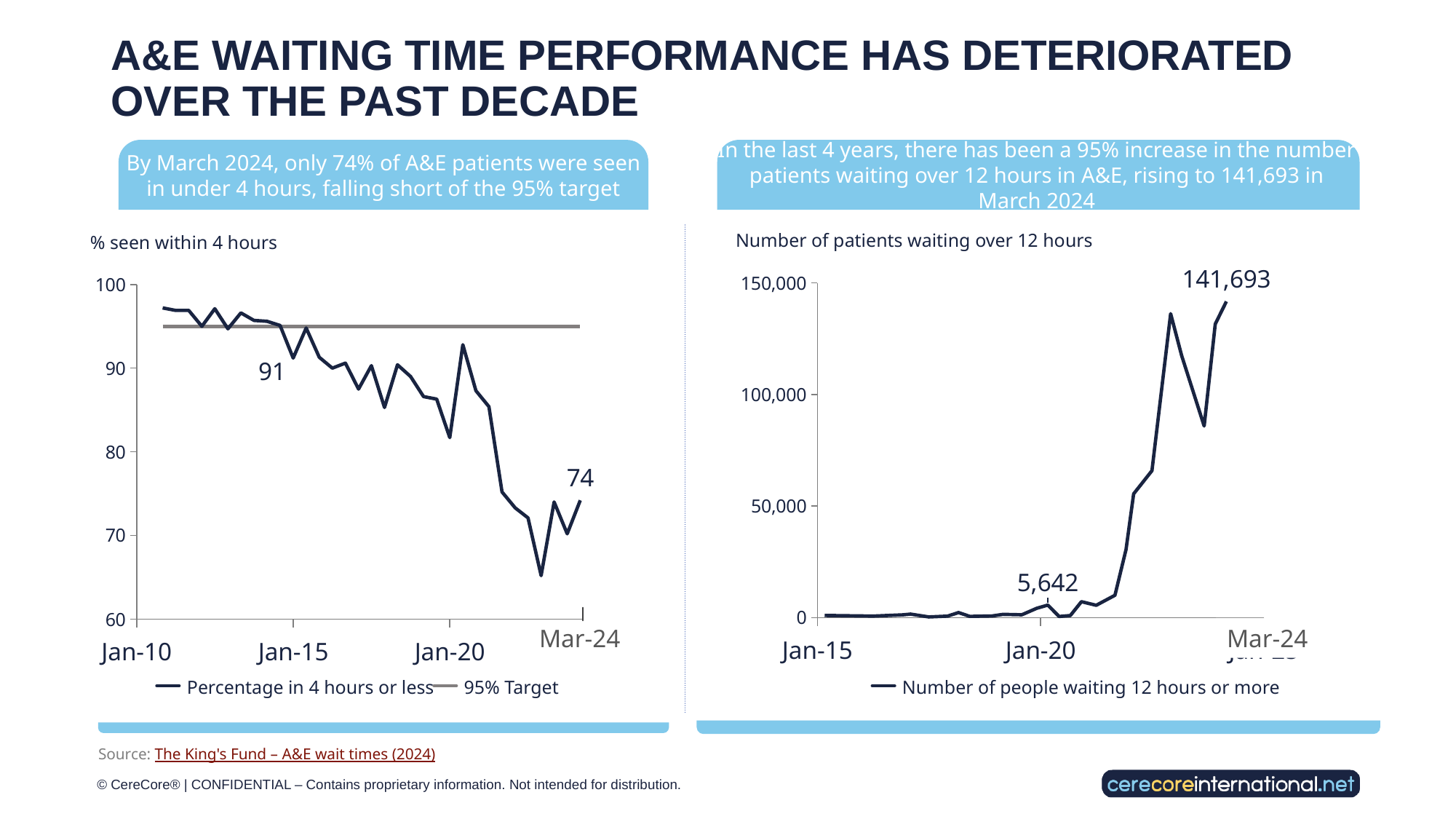
In the left chart (% seen within 4 hours), what value is labelled at Mar-24? 74 In the left chart (% seen within 4 hours), is the value at Jan-10 greater or less than 90? greater How many series does the legend of the right chart (Number of patients waiting over 12 hours) list? 1 In the right chart (Number of patients waiting over 12 hours), does the line generally rise or fall from Jan-15 to Mar-24? Rise In the left chart (% seen within 4 hours), what does the grey horizontal line represent according to the legend? 95% Target In the right chart (Number of patients waiting over 12 hours), what is the difference between the labelled Mar-24 value and the labelled Jan-20 value? 136,051 In the right chart (Number of patients waiting over 12 hours), what value is labelled near Jan-20? 5,642 How many series does the legend of the left chart (% seen within 4 hours) list? 2 In the right chart (Number of patients waiting over 12 hours), what value is labelled at Mar-24? 141,693 In the left chart (% seen within 4 hours), does the percentage line generally rise or fall from Jan-10 to Mar-24? Fall What kind of chart is the left chart (% seen within 4 hours)? Line chart In the left chart (% seen within 4 hours), what value is labelled near Jan-15? 91